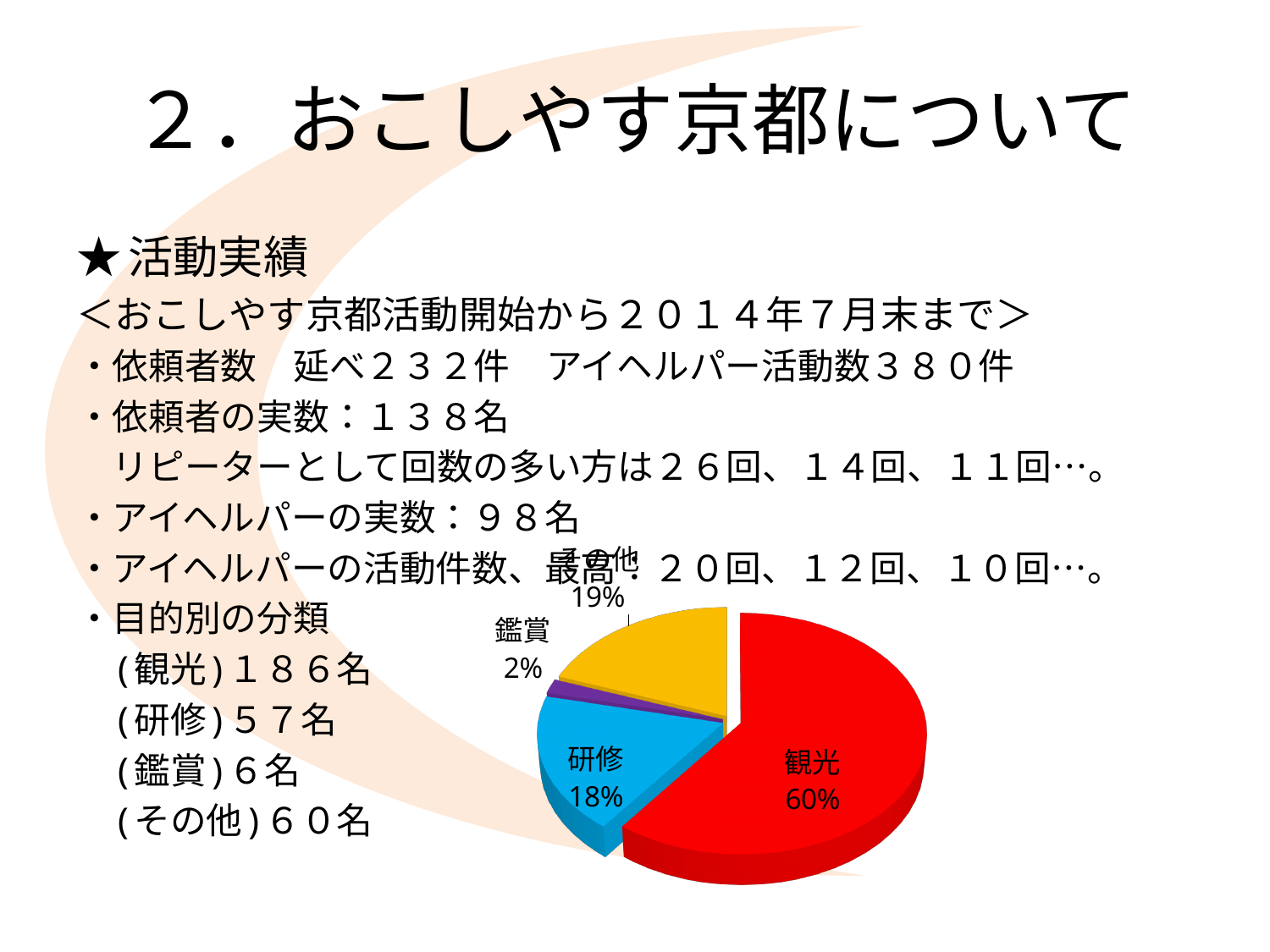
Which slice of the pie chart is the largest? 観光 Which is larger in the pie chart, 観光 or the yellow slice? 観光 What percentage does the 鑑賞 slice of the pie chart show? 2% What is the difference in percentage points between the 観光 slice and the 研修 slice? 42 How many slices does the pie chart have? 4 What percentage is shown for the yellow slice of the pie chart? 19% Which slice of the pie chart is the smallest? 鑑賞 What kind of chart is shown on the slide? pie chart What percentage does the 研修 slice of the pie chart show? 18% Which is larger in the pie chart, 研修 or 鑑賞? 研修 What percentage does the 観光 slice of the pie chart show? 60% What colour is the 観光 slice of the pie chart? red